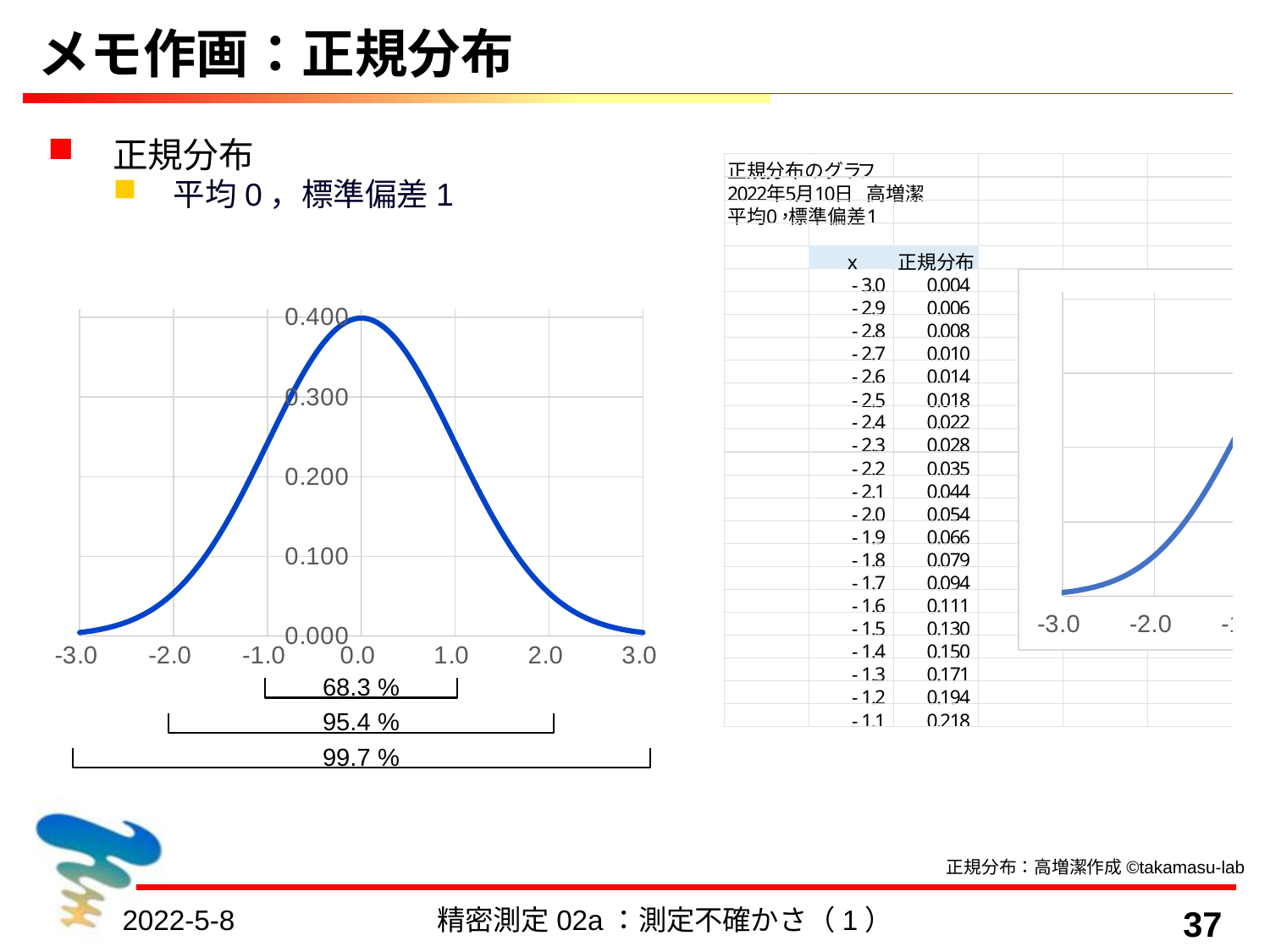
In the left chart, is the value at x = -1.0 greater or less than 0.200? greater According to the table on the right of the slide, what is the 正規分布 value at x = -3.0? 0.004 How many x-axis tick labels are shown on the left chart? 7 In the left chart, does the curve rise or fall as x goes from 0.0 to 3.0? fall In the left chart, does the curve rise or fall as x goes from -3.0 to 0.0? rise In the left chart, what percentage is written on the widest bracket below the x axis? 99.7 % In the left chart, is the value at x = 2.0 greater or less than 0.100? less In the left chart, at which x value does the curve reach its highest point? 0.0 In the left chart, what percentage is written on the bracket spanning from -1.0 to 1.0? 68.3 % In the left chart, which has the larger value: x = 1.0 or x = 2.0? x = 1.0 What kind of chart is shown on the left of the slide? line chart In the left chart, is the value at x = 0.0 greater or less than 0.300? greater